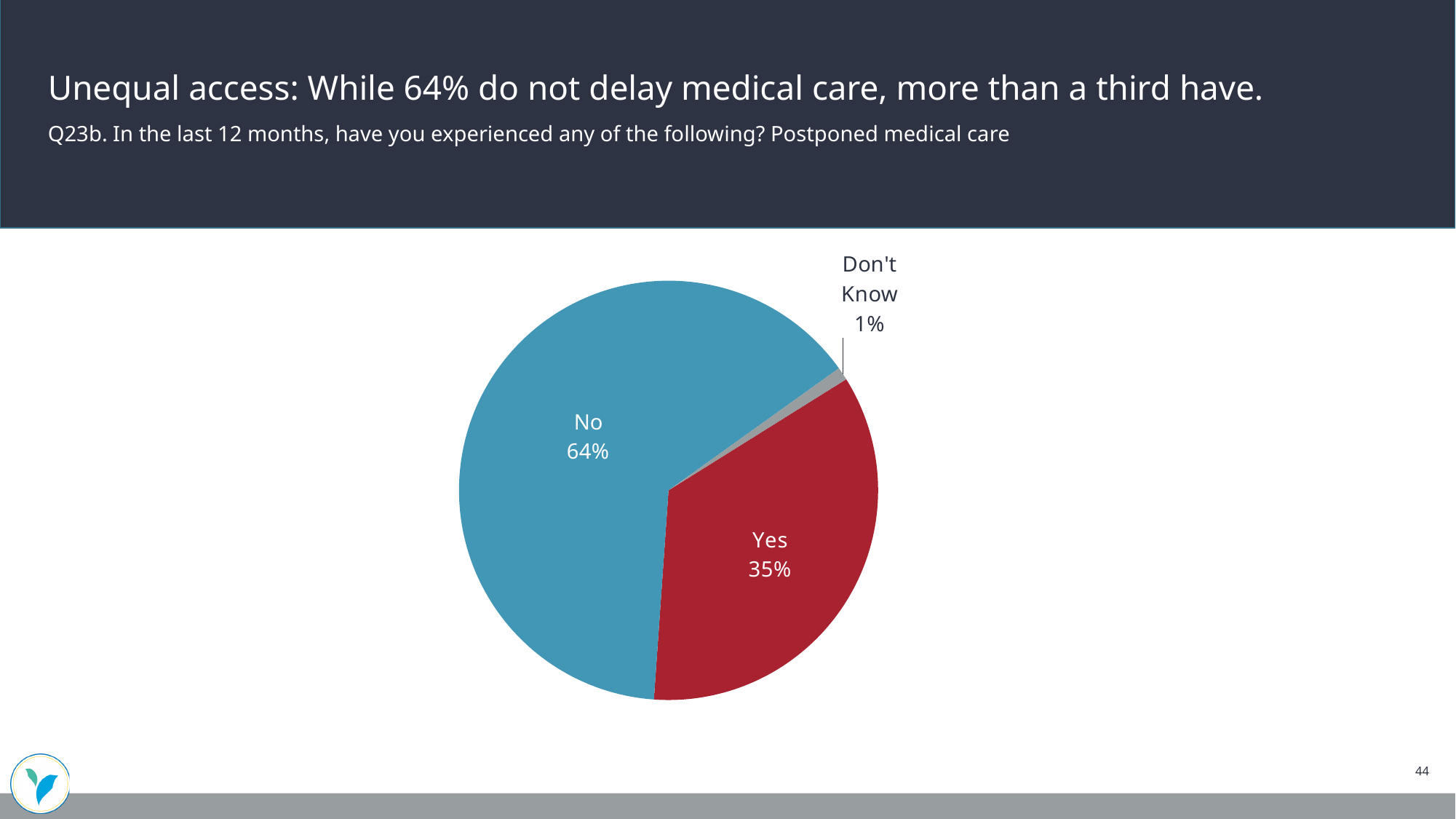
What percentage of respondents answered "Don't Know"? 1% What share of the pie does the "Yes" slice represent? 35% What kind of chart is shown on the slide? Pie chart How many slices does the pie chart have? 3 What percentage of respondents answered "Yes" to postponing medical care? 35% What colour is the "Yes" slice of the pie? Red Which response has the largest share of the pie? No Which response has the smallest share of the pie? Don't Know What colour is the "No" slice of the pie? Blue What is the difference in percentage points between the "No" and "Yes" slices? 29 What percentage of respondents answered "No" to postponing medical care? 64% Which slice is larger, "Yes" or "Don't Know"? Yes